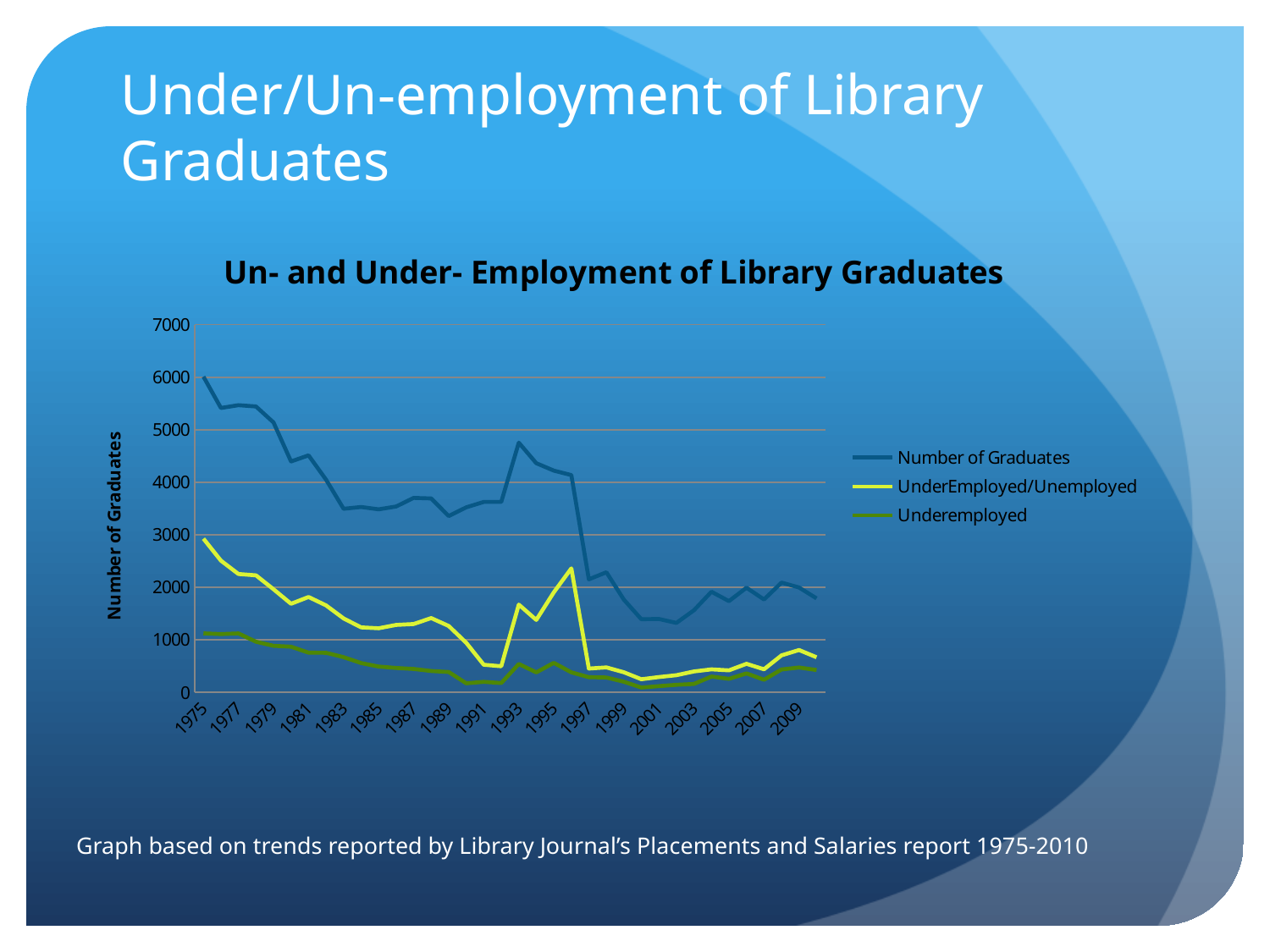
Which series has the highest values across the chart? Number of Graduates What is the title of the chart? Un- and Under- Employment of Library Graduates Is the value for Number of Graduates in 1983 greater or less than 4000? less In 1975, which is larger: Number of Graduates or UnderEmployed/Unemployed? Number of Graduates What kind of chart is shown on the slide? line chart In which year is the Number of Graduates highest? 1975 Is the value for Underemployed in 1991 greater or less than 1000? less How many series does the legend list? 3 Does the Number of Graduates line generally rise or fall from 1975 to 2009? fall What is the label on the vertical axis? Number of Graduates Is the value for Number of Graduates in 1977 greater or less than 5000? greater